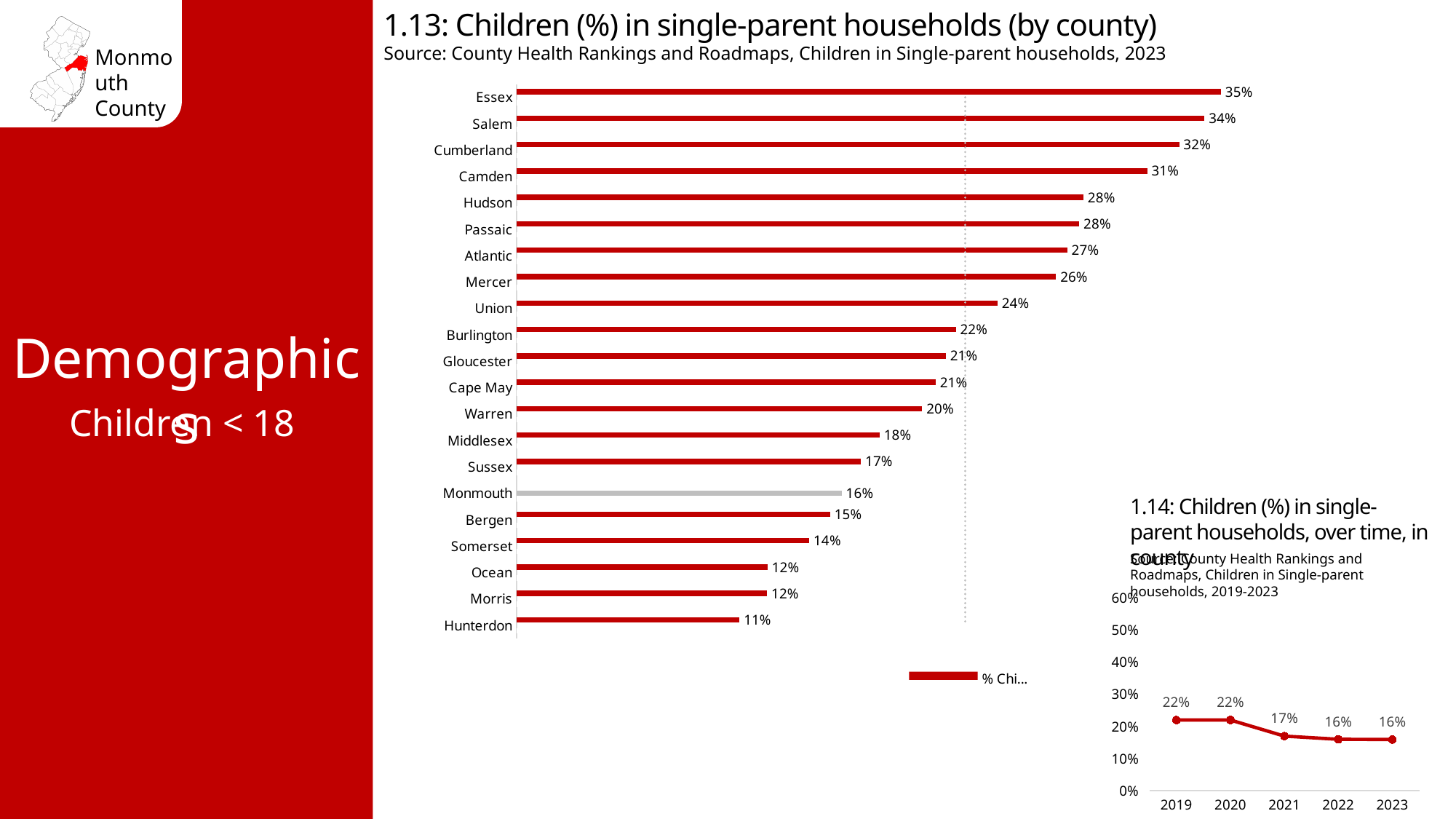
In chart 1.14 (Children (%) in single-parent households over time), what is the value for 2021? 17% In chart 1.14 (over time), do the values rise or fall from 2019 to 2023? Fall In chart 1.13 (by county), which is larger, the value for Union or the value for Bergen? Union In chart 1.13 (Children (%) in single-parent households by county), what is the value for Monmouth? 16% In chart 1.13 (by county), which county has the highest percentage of children in single-parent households? Essex In chart 1.13 (by county), which bar is shown in a different colour (grey) from the others? Monmouth In chart 1.13 (by county), what is the difference between Essex and Monmouth? 19 percentage points In chart 1.13 (by county), which county has the lowest percentage of children in single-parent households? Hunterdon What kind of chart is chart 1.13 (Children (%) in single-parent households by county)? Bar chart In chart 1.14 (over time), what is the difference between the 2019 value and the 2023 value? 6 percentage points In chart 1.13 (by county), how many counties are shown? 21 In chart 1.13 (by county), what is the value for Camden? 31%